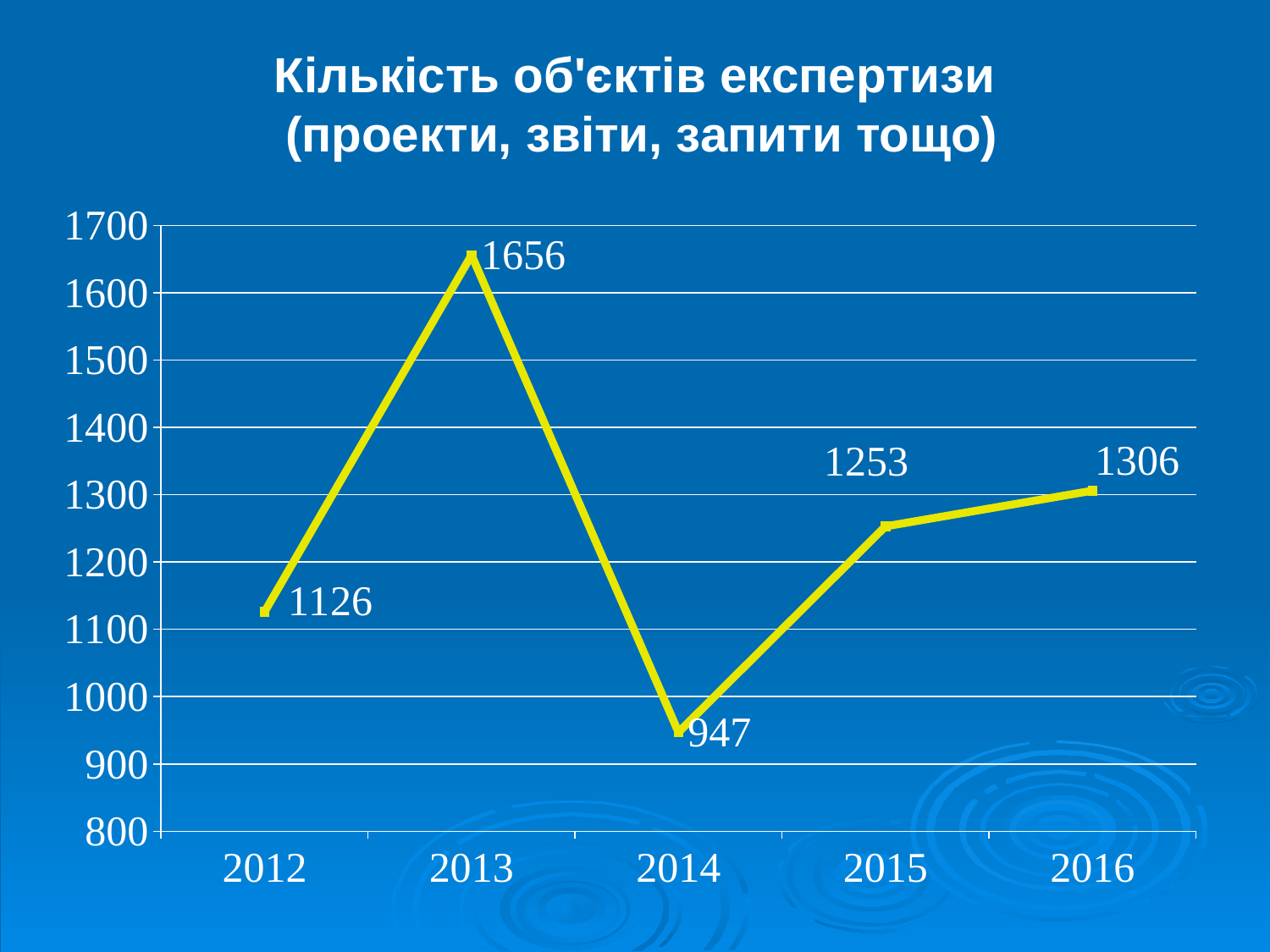
Which is larger, the value for 2012 or the value for 2015? 2015 What is the value for 2013? 1656 Which year has the highest value? 2013 How many years are plotted on the chart? 5 Which year has the lowest value? 2014 What is the difference between the values for 2013 and 2014? 709 Does the value rise or fall from 2014 to 2015? rise What kind of chart is shown on the slide? line chart What is the value for 2014? 947 What is the difference between the values for 2016 and 2015? 53 What is the value for 2016? 1306 Is the value for 2014 greater or less than 1000? less